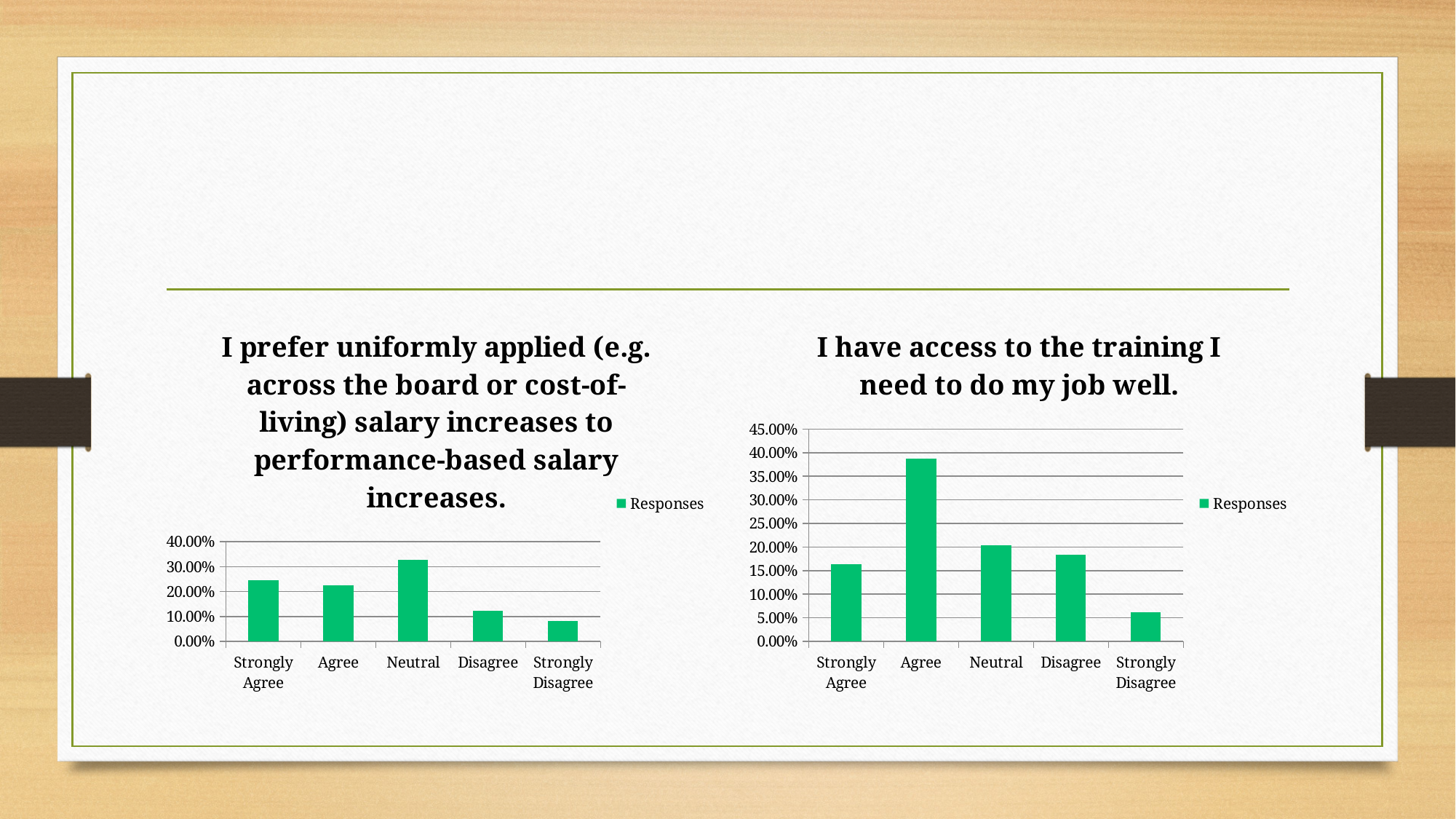
In the left chart about uniformly applied salary increases, which category has the lowest value? Strongly Disagree What kind of chart is the chart titled "I have access to the training I need to do my job well."? Bar chart In the chart titled "I have access to the training I need to do my job well.", which category has the highest value? Agree How many series does the legend of the chart titled "I have access to the training I need to do my job well." list? 1 In the left chart about uniformly applied salary increases, which category has the highest value? Neutral In the chart titled "I have access to the training I need to do my job well.", which category has the lowest value? Strongly Disagree In the chart titled "I have access to the training I need to do my job well.", which is larger, the value for Agree or the value for Neutral? Agree In the left chart about uniformly applied salary increases, is the value for Neutral greater or less than 30.00%? greater In the chart titled "I have access to the training I need to do my job well.", is the value for Strongly Disagree greater or less than 10.00%? less In the left chart about uniformly applied salary increases, is the value for Disagree greater or less than 20.00%? less How many categories are shown on the x axis of the left chart about uniformly applied salary increases? 5